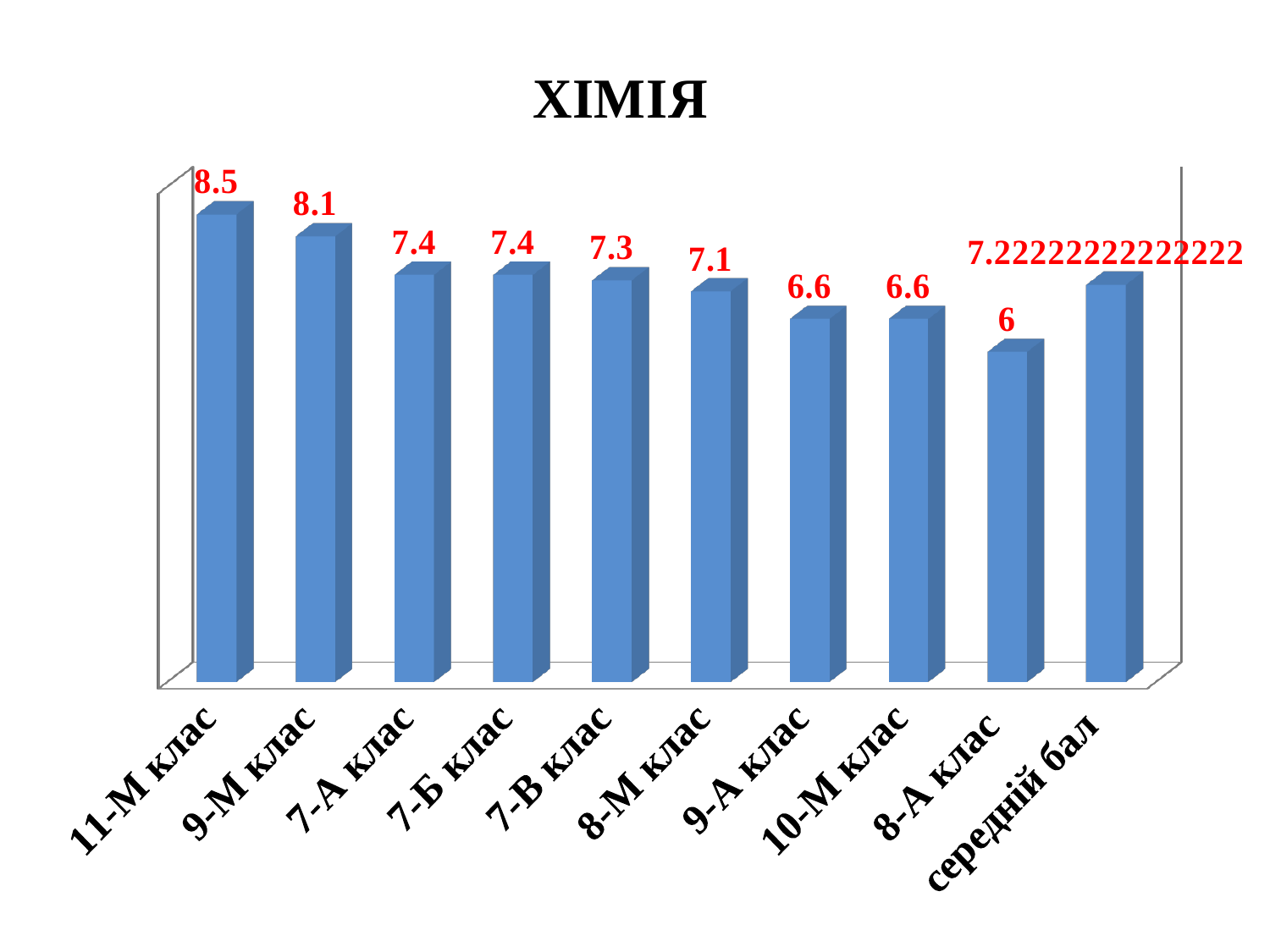
What kind of chart is this? bar chart Which is larger, the value for 7-В клас or the value for 9-А клас? 7-В клас What is the value for 9-М клас? 8.1 Which category has the highest value? 11-М клас What value is shown for середній бал? 7.22222222222222 How many categories are shown on the x axis? 10 What is the difference between the values for 11-М клас and 8-А клас? 2.5 Which category has the lowest value? 8-А клас What is the value for 8-А клас? 6 What is the difference between the values for 9-М клас and 8-М клас? 1 What is the title of the chart? ХІМІЯ What is the value for 11-М клас? 8.5